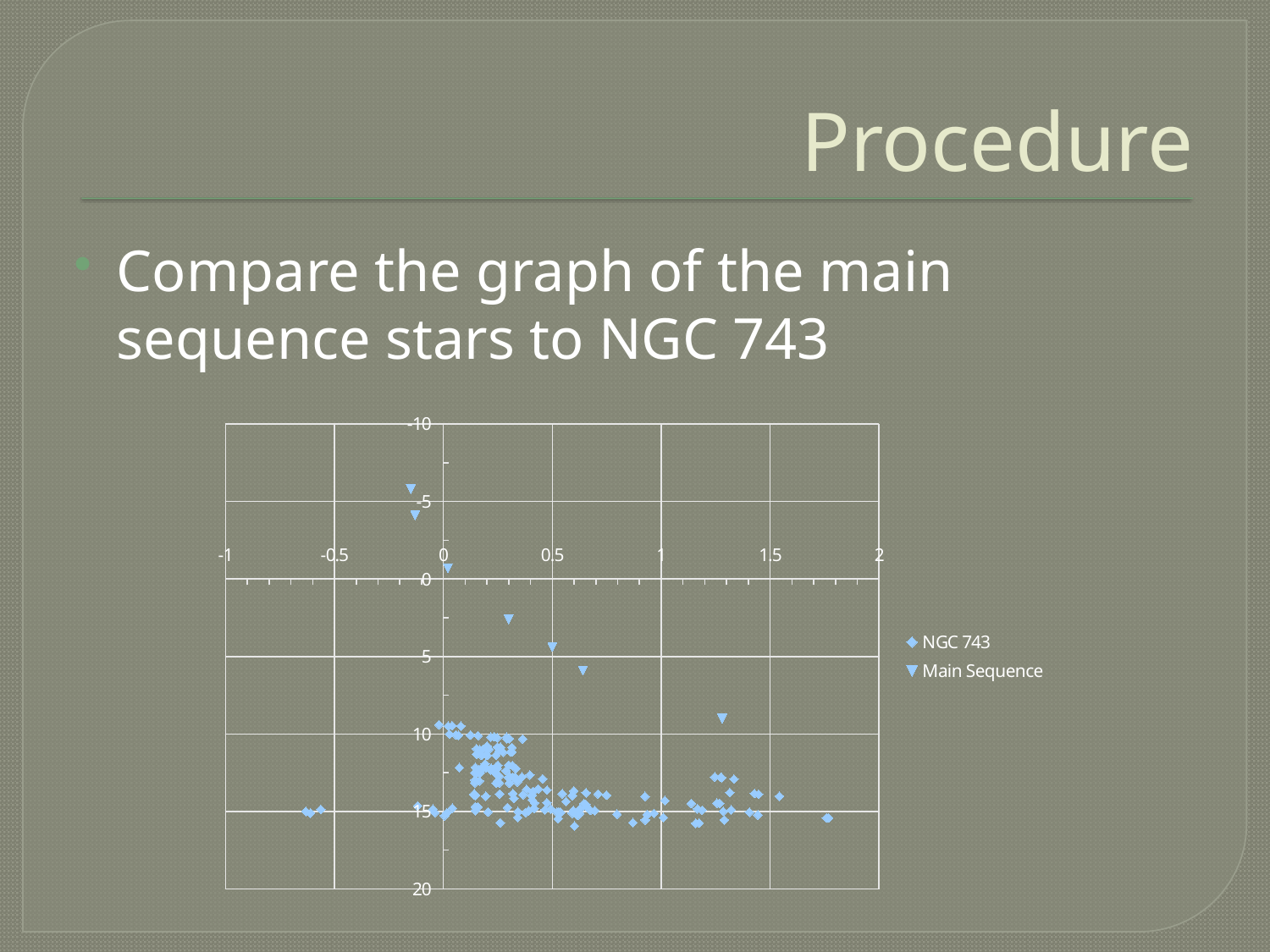
What is the lowest value shown on the chart's x axis? -1 Which marker shape is used for the Main Sequence series in the chart? Triangles What kind of chart is shown on the slide? Scatter chart Is the y-value of the Main Sequence point near x = 1.3 greater or less than 5? greater What is the highest value shown on the chart's x axis? 2 How many Main Sequence points are plotted on the chart? 7 How many series does the chart legend list? 2 Which series has more plotted points, NGC 743 or Main Sequence? NGC 743 Are most of the NGC 743 points plotted at y-values greater or less than 10? greater Do the y-values of the Main Sequence points increase or decrease as x increases? Increase